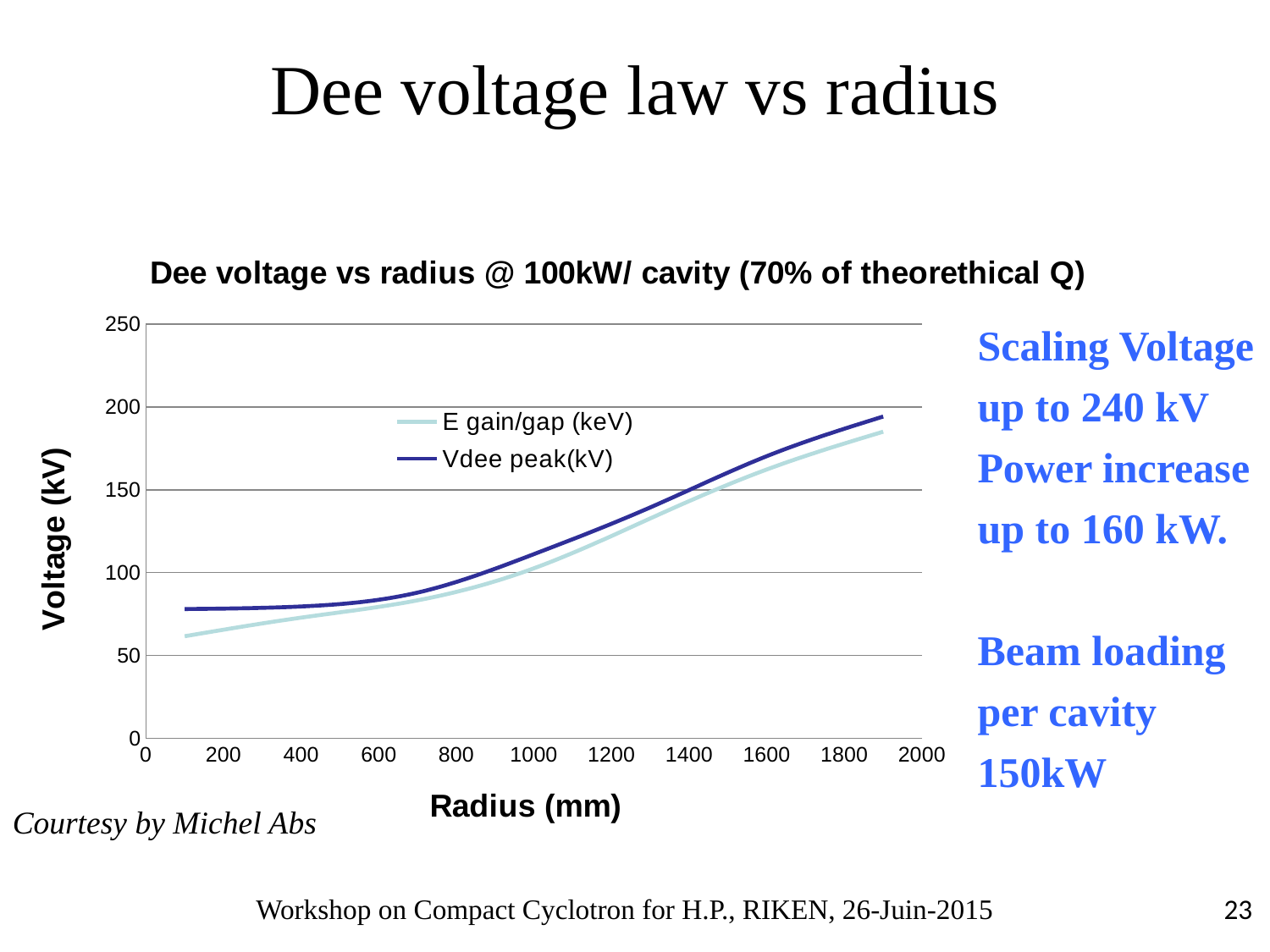
Do the values of the Vdee peak(kV) series rise or fall as the radius increases? rise Is the value of Vdee peak(kV) at a radius of 1600 mm greater or less than 150? greater Is the value of Vdee peak(kV) at a radius of 1800 mm greater or less than 150? greater Do the values of the E gain/gap (keV) series rise or fall along the x axis? rise Is the value of E gain/gap (keV) at a radius of 600 mm greater or less than 100? less At a radius of 200 mm, which series has the higher value, E gain/gap (keV) or Vdee peak(kV)? Vdee peak(kV) What is the title of the chart? Dee voltage vs radius @ 100kW/ cavity (70% of theorethical Q) What are the two series named in the chart legend? E gain/gap (keV) and Vdee peak(kV) What kind of chart is shown on the slide? line chart How many series does the chart legend list? 2 At a radius of 600 mm, which series has the lower value, E gain/gap (keV) or Vdee peak(kV)? E gain/gap (keV)